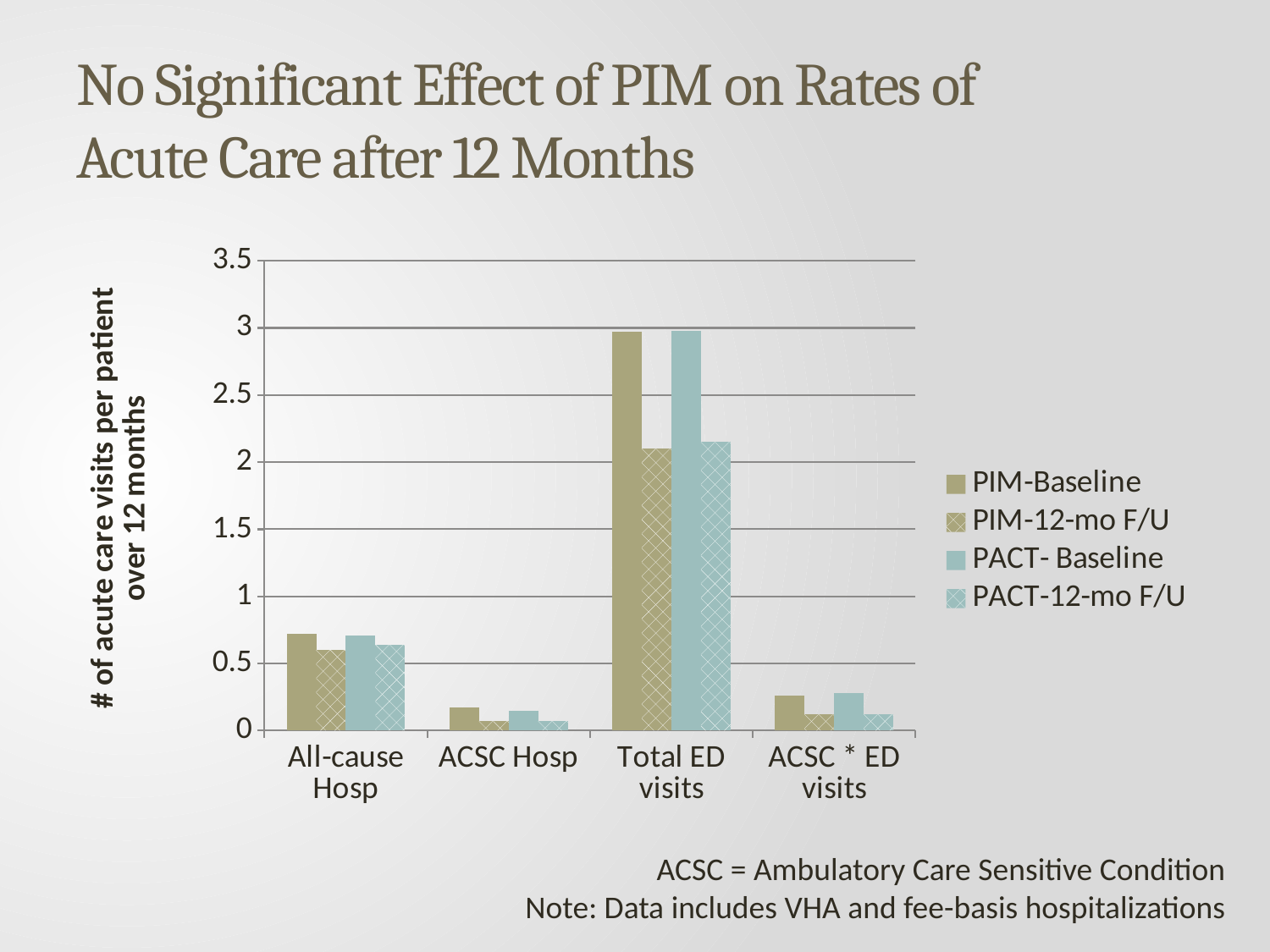
For the PIM-Baseline series, which category has the highest value? Total ED visits What is the title of the y axis? # of acute care visits per patient over 12 months Is the PIM-12-mo F/U value for Total ED visits greater or less than 2.5? less Is the PIM-Baseline value for Total ED visits greater or less than 2.5? greater How many categories are shown on the x axis? 4 Which legend entry is shown with a solid blue fill? PACT- Baseline Is the PIM-Baseline value for All-cause Hosp greater or less than 0.5? greater For Total ED visits, which is larger: PIM-Baseline or PIM-12-mo F/U? PIM-Baseline For the PIM-Baseline series, which category has the lowest value? ACSC Hosp How many series does the legend list? 4 What kind of chart is shown on the slide? bar chart